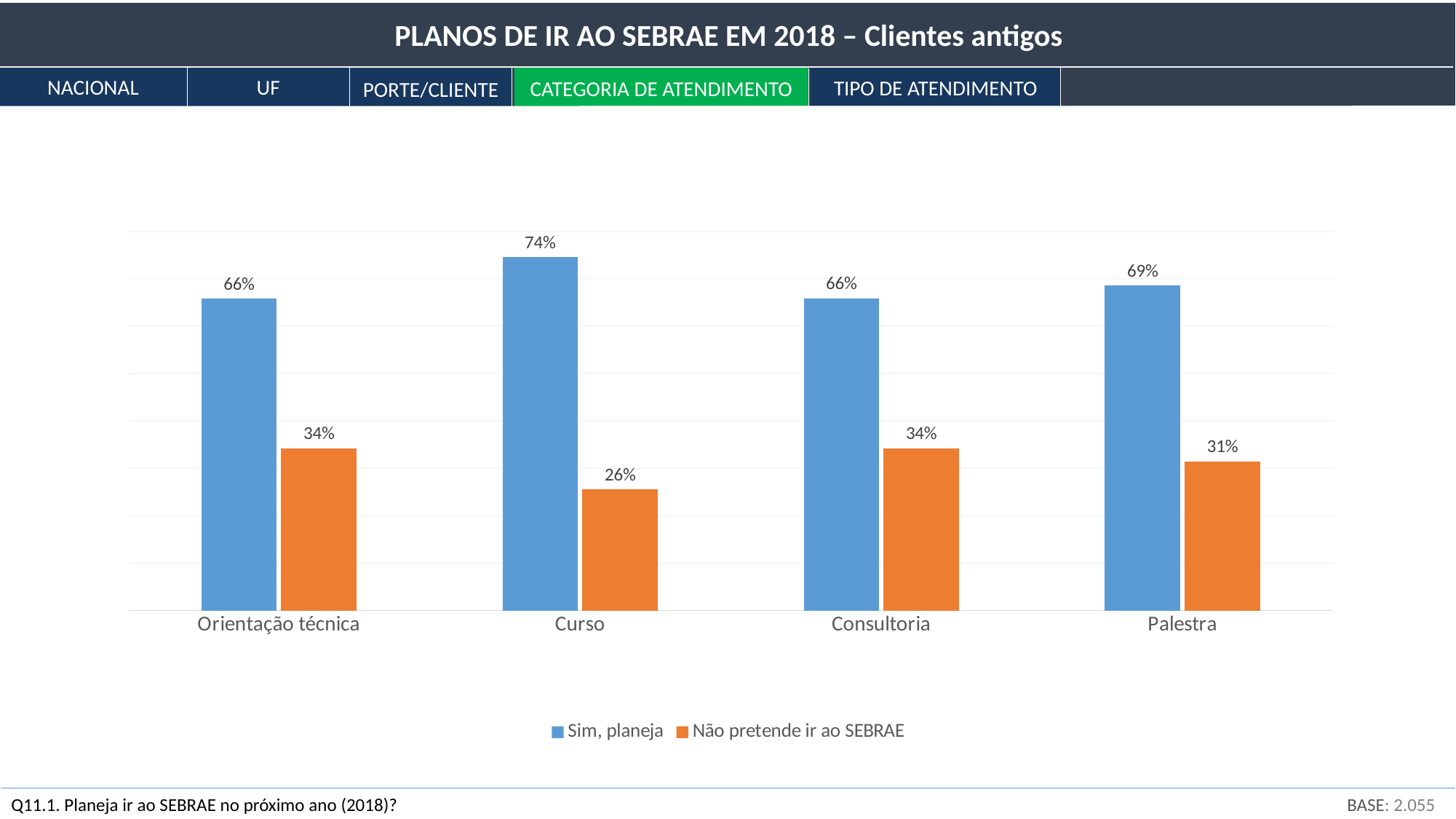
Which is larger: "Sim, planeja" for Curso or "Sim, planeja" for Palestra? Curso What kind of chart is shown on the slide? Bar chart Which category has the highest value for "Sim, planeja"? Curso What is the value of "Sim, planeja" for Curso? 74% What is the value of "Sim, planeja" for Orientação técnica? 66% How many categories are shown on the x axis? 4 What is the value of "Não pretende ir ao SEBRAE" for Palestra? 31% What is the difference between "Sim, planeja" and "Não pretende ir ao SEBRAE" for Palestra? 38% Which category has the lowest value for "Não pretende ir ao SEBRAE"? Curso How many series does the legend list? 2 What is the value of "Não pretende ir ao SEBRAE" for Curso? 26% Which colour represents the "Não pretende ir ao SEBRAE" series? Orange